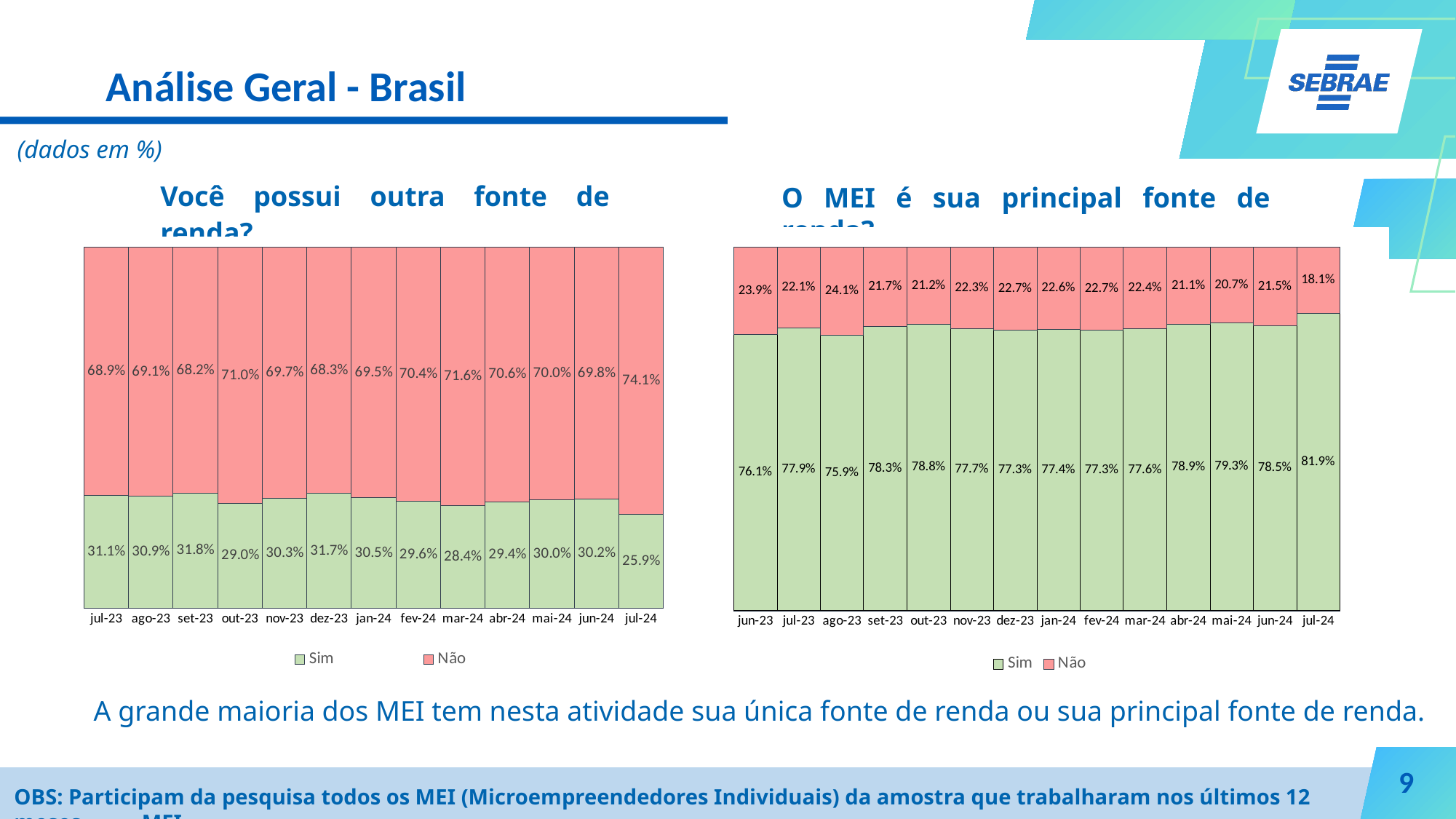
In the left chart ("Você possui outra fonte de renda?"), what is the value for Sim in jul-24? 25.9% What type of chart is the right chart ("O MEI é sua principal fonte de renda?")? stacked bar chart How many months are shown on the x axis of the left chart ("Você possui outra fonte de renda?")? 13 How many months are shown on the x axis of the right chart ("O MEI é sua principal fonte de renda?")? 14 In the left chart ("Você possui outra fonte de renda?"), what is the value for Não in mar-24? 71.6% In the right chart ("O MEI é sua principal fonte de renda?"), what is the difference between the Sim values for jul-24 and jun-23? 5.8% In the right chart ("O MEI é sua principal fonte de renda?"), what is the value for Não in ago-23? 24.1% In the right chart ("O MEI é sua principal fonte de renda?"), which month has the lowest Não value? jul-24 In the right chart ("O MEI é sua principal fonte de renda?"), what is the value for Sim in jul-24? 81.9% In the left chart ("Você possui outra fonte de renda?"), which month has the highest Sim value? set-23 In the left chart ("Você possui outra fonte de renda?"), is the Não value for jul-24 larger or smaller than the Não value for jun-24? larger How many series does the legend of the left chart ("Você possui outra fonte de renda?") list? 2